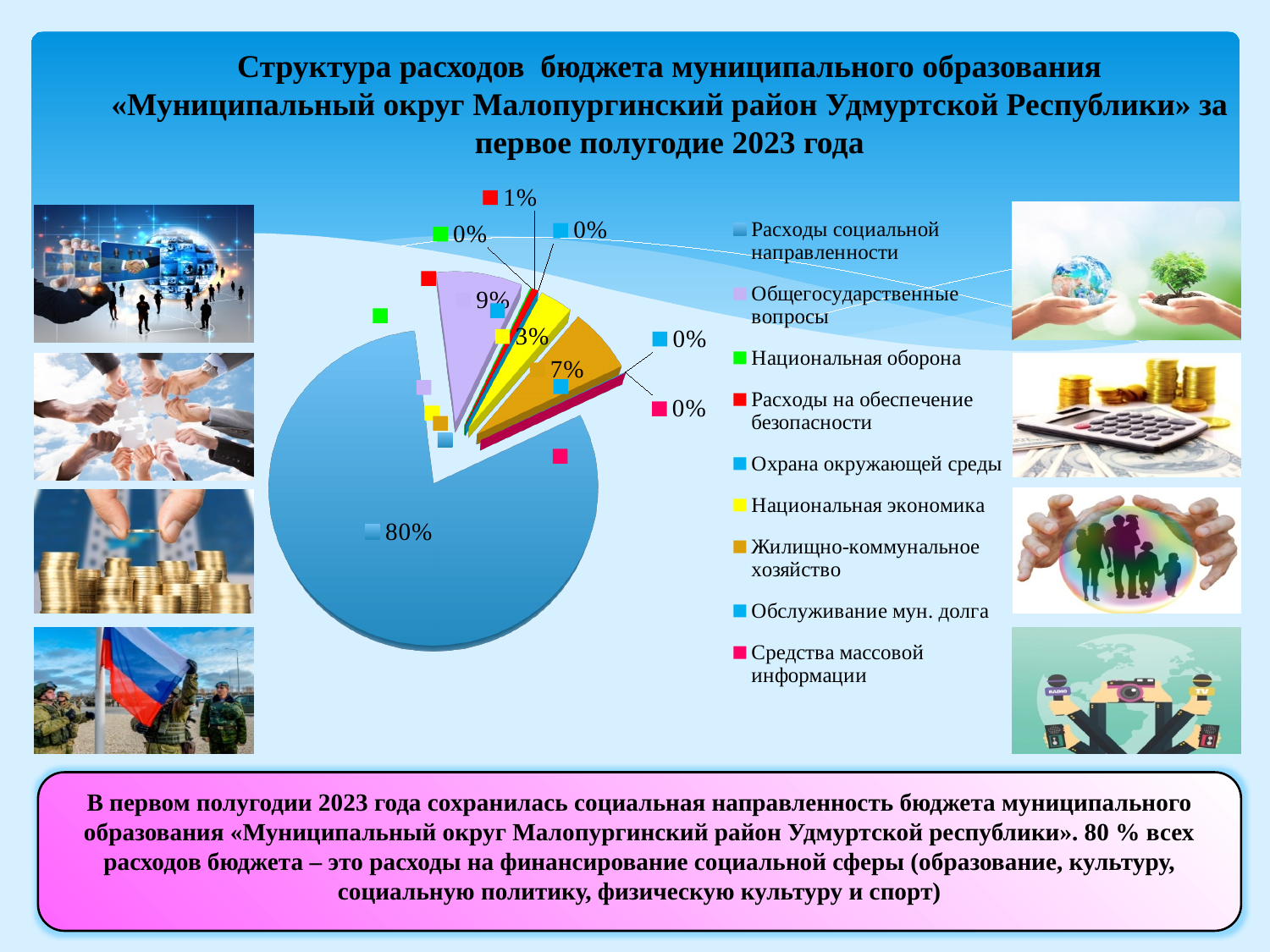
What share is shown for «Национальная оборона»? 0% What share is shown for «Жилищно-коммунальное хозяйство»? 7% Which is larger: the share for «Общегосударственные вопросы» or for «Жилищно-коммунальное хозяйство»? Общегосударственные вопросы How many categories does the legend list? 9 What kind of chart is shown on the slide? pie chart What is the difference between the shares for «Общегосударственные вопросы» and «Национальная экономика»? 6% What share is shown for «Общегосударственные вопросы»? 9% Which category has the largest share of the pie? Расходы социальной направленности What share of budget expenditures is shown for «Расходы социальной направленности»? 80% What share is shown for «Национальная экономика»? 3% What colour is the slice for «Национальная экономика»? yellow What share is shown for «Расходы на обеспечение безопасности»? 1%